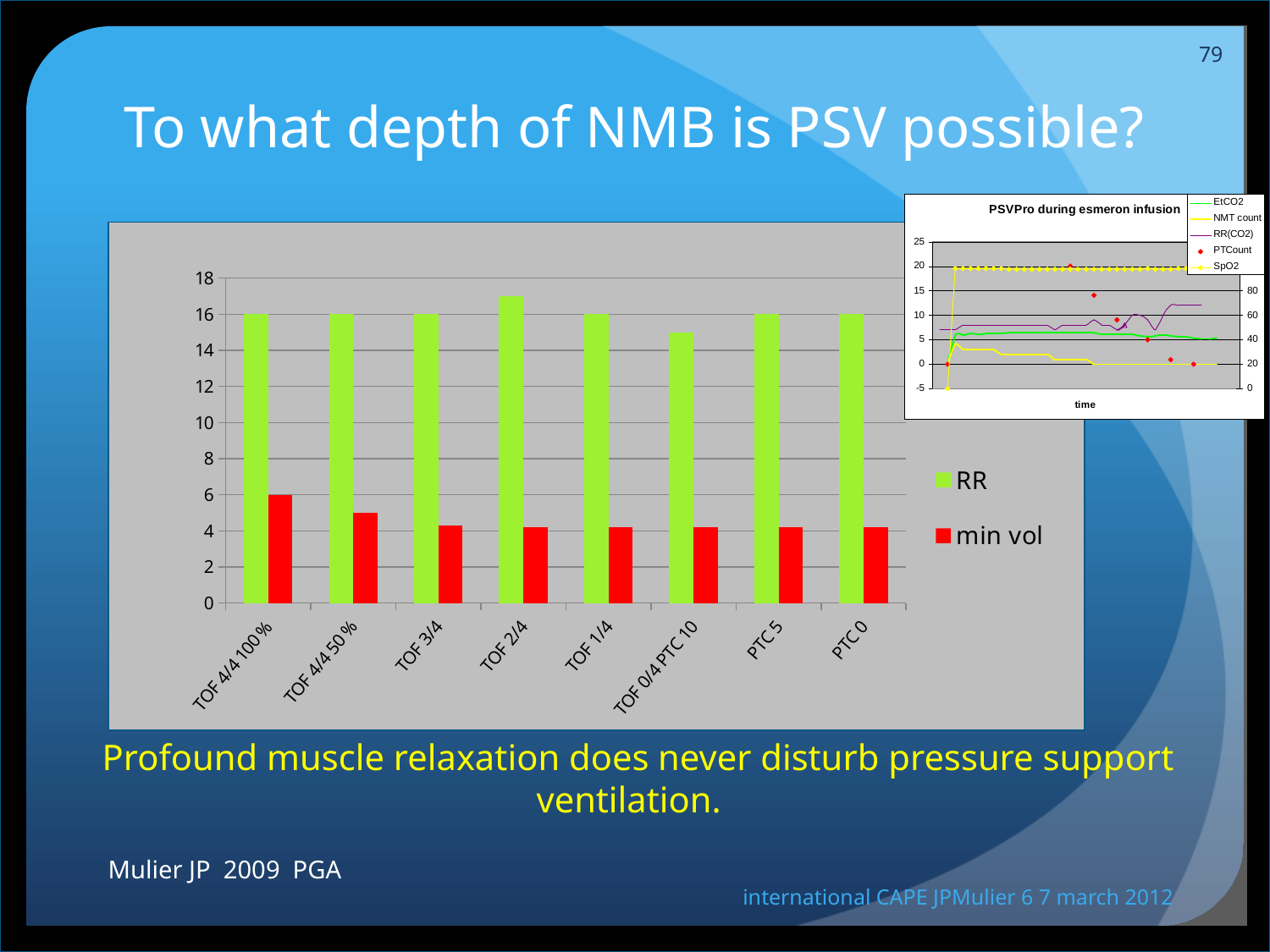
In the large bar chart, for PTC 5, which is larger: RR or min vol? RR In the large bar chart, which category has the highest RR value? TOF 2/4 In the large bar chart, what is the RR value for TOF 4/4 100%? 16 What kind of chart is the large chart on the left of the slide? bar chart What is the title of the small inset chart in the top right of the slide? PSVPro during esmeron infusion In the large bar chart, what is the min vol value for TOF 4/4 100%? 6 In the large bar chart, is the RR value for PTC 0 greater or less than 10? greater In the large bar chart, which category has the highest min vol value? TOF 4/4 100% In the large bar chart, is the min vol value for TOF 3/4 greater or less than 6? less In the large bar chart, which category has the lowest RR value? TOF 0/4 PTC 10 How many series does the legend of the large bar chart list? 2 How many categories are shown on the x axis of the large bar chart? 8